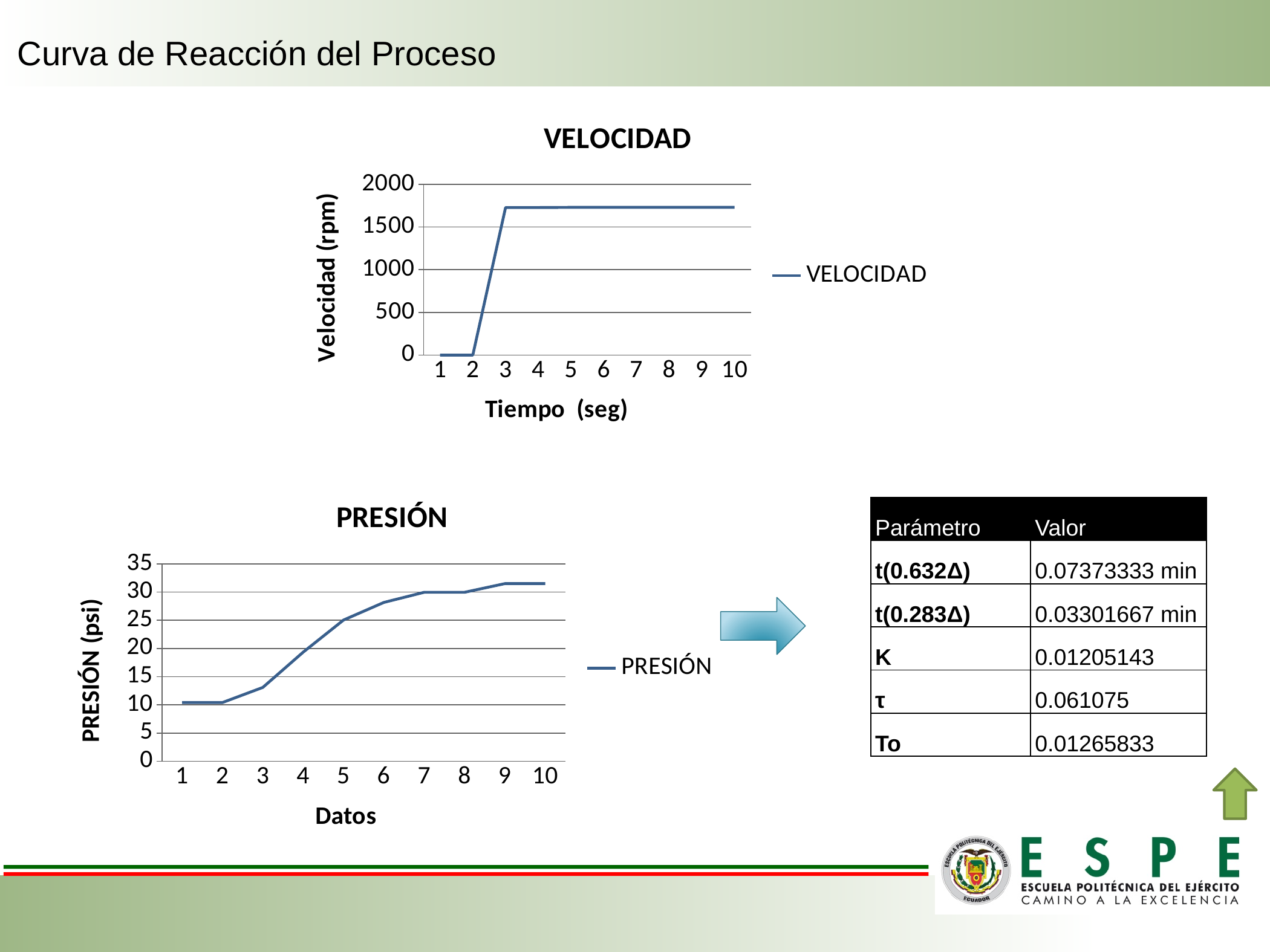
In the VELOCIDAD chart, is the value at time 5 greater or less than 1500? greater What is the y-axis title of the PRESIÓN chart? PRESIÓN (psi) In the PRESIÓN chart, do the values generally rise or fall from data point 1 to data point 10? rise What kind of chart is the VELOCIDAD chart? line chart In the VELOCIDAD chart, is the value at time 2 greater or less than 500? less In the PRESIÓN chart, which is larger, the value at data point 3 or the value at data point 7? data point 7 What is the x-axis title of the VELOCIDAD chart? Tiempo (seg) What kind of chart is the PRESIÓN chart? line chart In the PRESIÓN chart, is the value at data point 4 greater or less than 15? greater How many series does the legend of the PRESIÓN chart list? 1 How many data points are plotted on the VELOCIDAD chart? 10